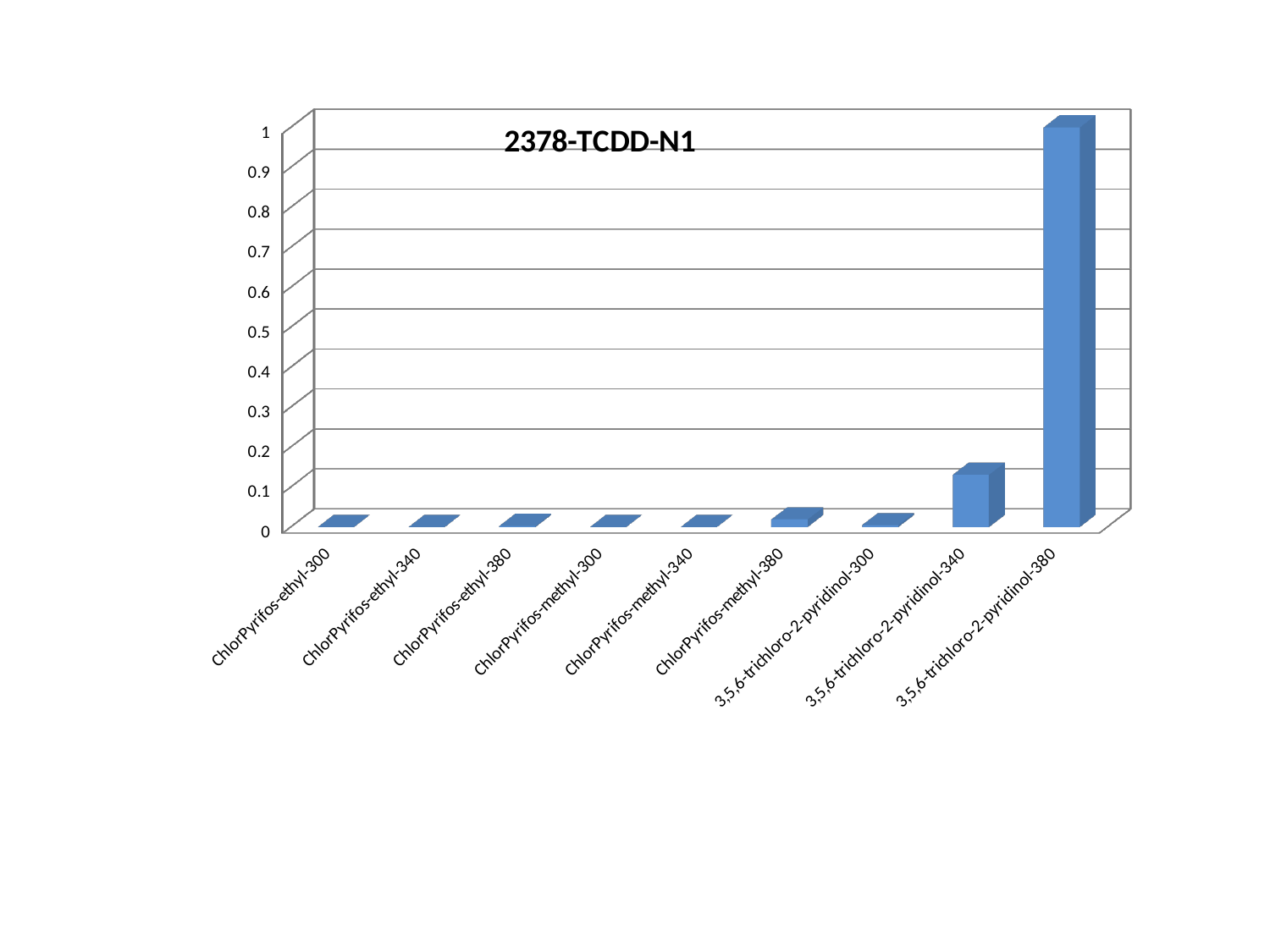
Which is larger, the value for ChlorPyrifos-methyl-380 or for 3,5,6-trichloro-2-pyridinol-340? 3,5,6-trichloro-2-pyridinol-340 What is the title of the chart? 2378-TCDD-N1 Is the value for 3,5,6-trichloro-2-pyridinol-380 greater or less than 0.9? greater Which is larger, the value for 3,5,6-trichloro-2-pyridinol-380 or for 3,5,6-trichloro-2-pyridinol-340? 3,5,6-trichloro-2-pyridinol-380 What kind of chart is shown on the slide? bar chart Is the value for 3,5,6-trichloro-2-pyridinol-340 greater or less than 0.1? greater Is the value for 3,5,6-trichloro-2-pyridinol-340 greater or less than 0.2? less Do the values for the three 3,5,6-trichloro-2-pyridinol categories rise or fall from 300 to 380? rise What is the highest value shown on the vertical axis? 1 How many categories are plotted on the x axis? 9 Which category has the highest value? 3,5,6-trichloro-2-pyridinol-380